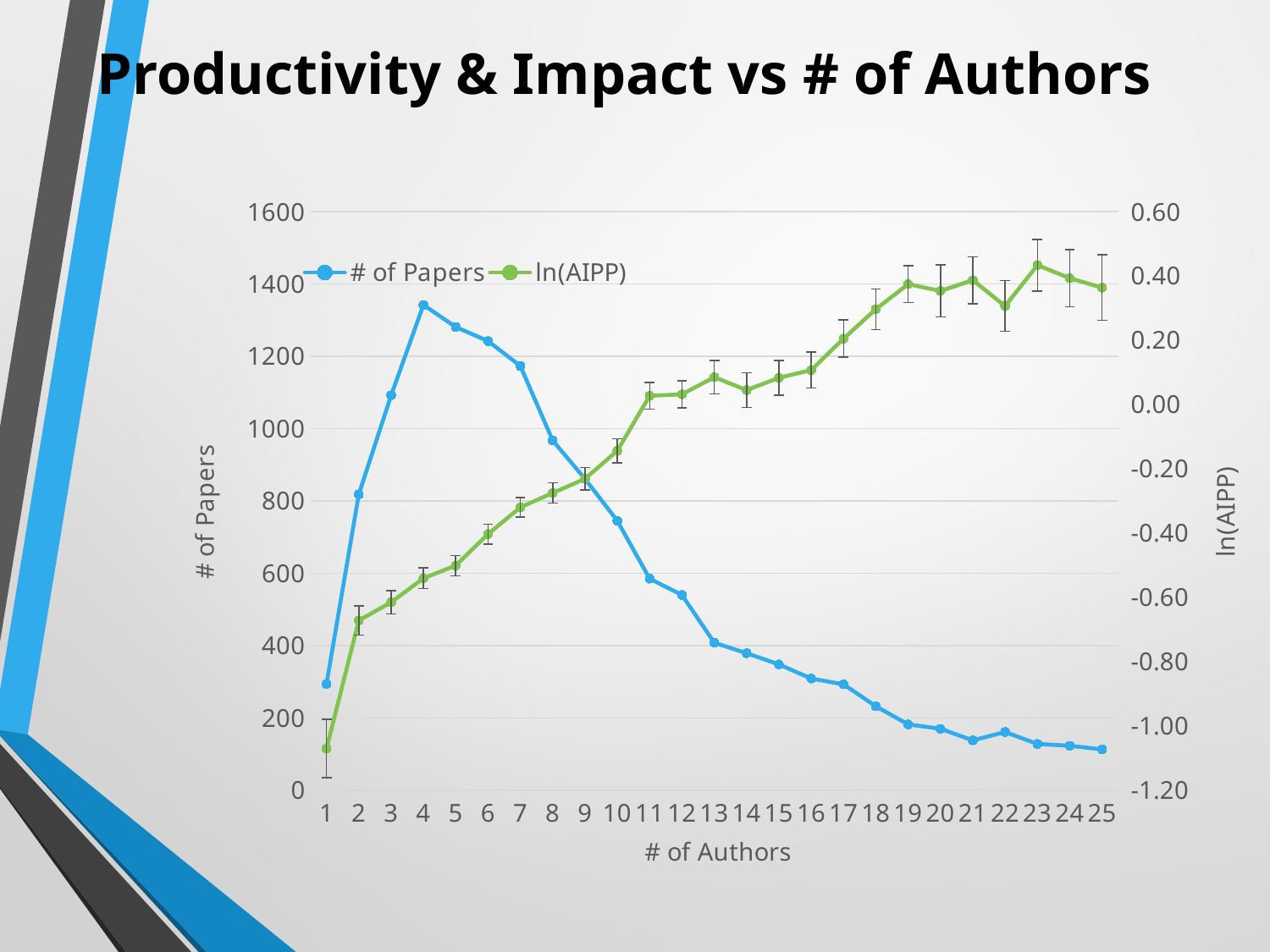
What kind of chart is shown on the slide? line chart How many series does the legend list? 2 At which # of Authors is the # of Papers series highest? 4 Is the ln(AIPP) value for 25 authors greater or less than 0.20? greater How many values of # of Authors are plotted along the x axis? 25 At which # of Authors is the ln(AIPP) series lowest? 1 Does the ln(AIPP) series generally rise or fall as # of Authors increases? rise At which # of Authors is the ln(AIPP) series highest? 23 Which has the higher ln(AIPP): 2 authors or 20 authors? 20 authors Is the # of Papers value for 13 authors greater or less than 600? less Which has more papers: 4 authors or 10 authors? 4 authors Is the # of Papers value for 4 authors greater or less than 1200? greater